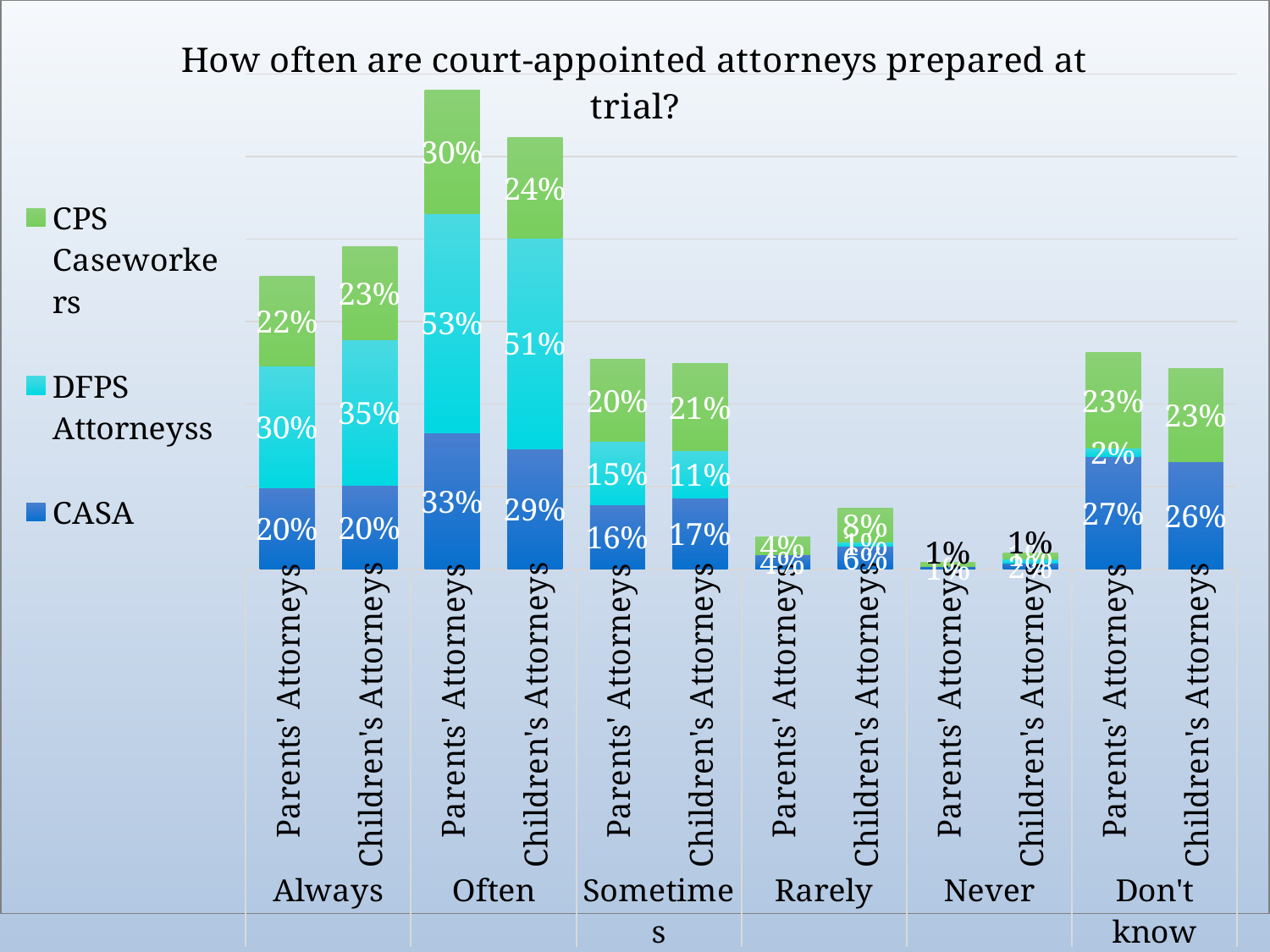
What type of chart is shown on the slide? Stacked bar chart What is the title of the chart? How often are court-appointed attorneys prepared at trial? What is the total of the stacked bar for Parents' Attorneys in the Always category? 72% Which frequency category has the tallest stacked bars overall? Often Which frequency category has the shortest stacked bars overall? Never What is the DFPS Attorneys value for Children's Attorneys in the Always category? 35% What is the CASA value for Parents' Attorneys in the Often category? 33% What is the CASA value for Children's Attorneys in the Don't know category? 26% Which is larger: the CPS Caseworkers value for Parents' Attorneys in the Often category or for Children's Attorneys in the Often category? Parents' Attorneys What is the CPS Caseworkers value for Children's Attorneys in the Often category? 24% What is the difference between the DFPS Attorneys values for Parents' Attorneys and Children's Attorneys in the Often category? 2% How many series does the legend list? 3